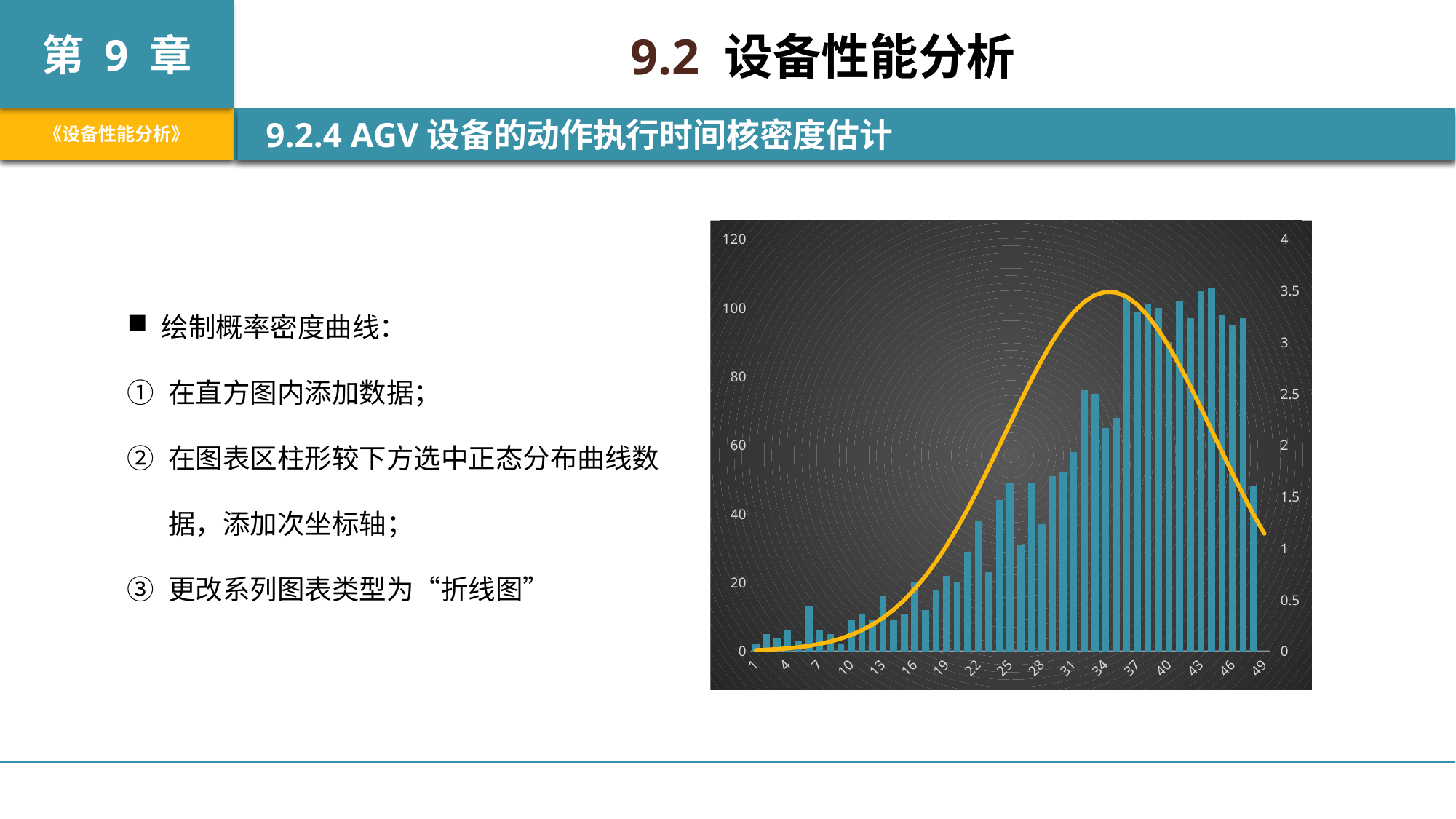
Is the line value at x = 49 greater or less than 1.5 on the right axis? less Do the bar values generally rise or fall from x = 1 to x = 43? rise Which bar is taller, the one at x = 37 or the one at x = 13? x = 37 What kind of chart is shown on the slide? A combination of a bar chart and a line chart Is the bar value at x = 4 greater or less than 20 on the left axis? less Is the line value at x = 1 greater or less than 0.5 on the right axis? less What is the highest tick value shown on the right vertical axis? 4 Does the line rise or fall from x = 37 to x = 49? fall What is the highest tick value shown on the left vertical axis? 120